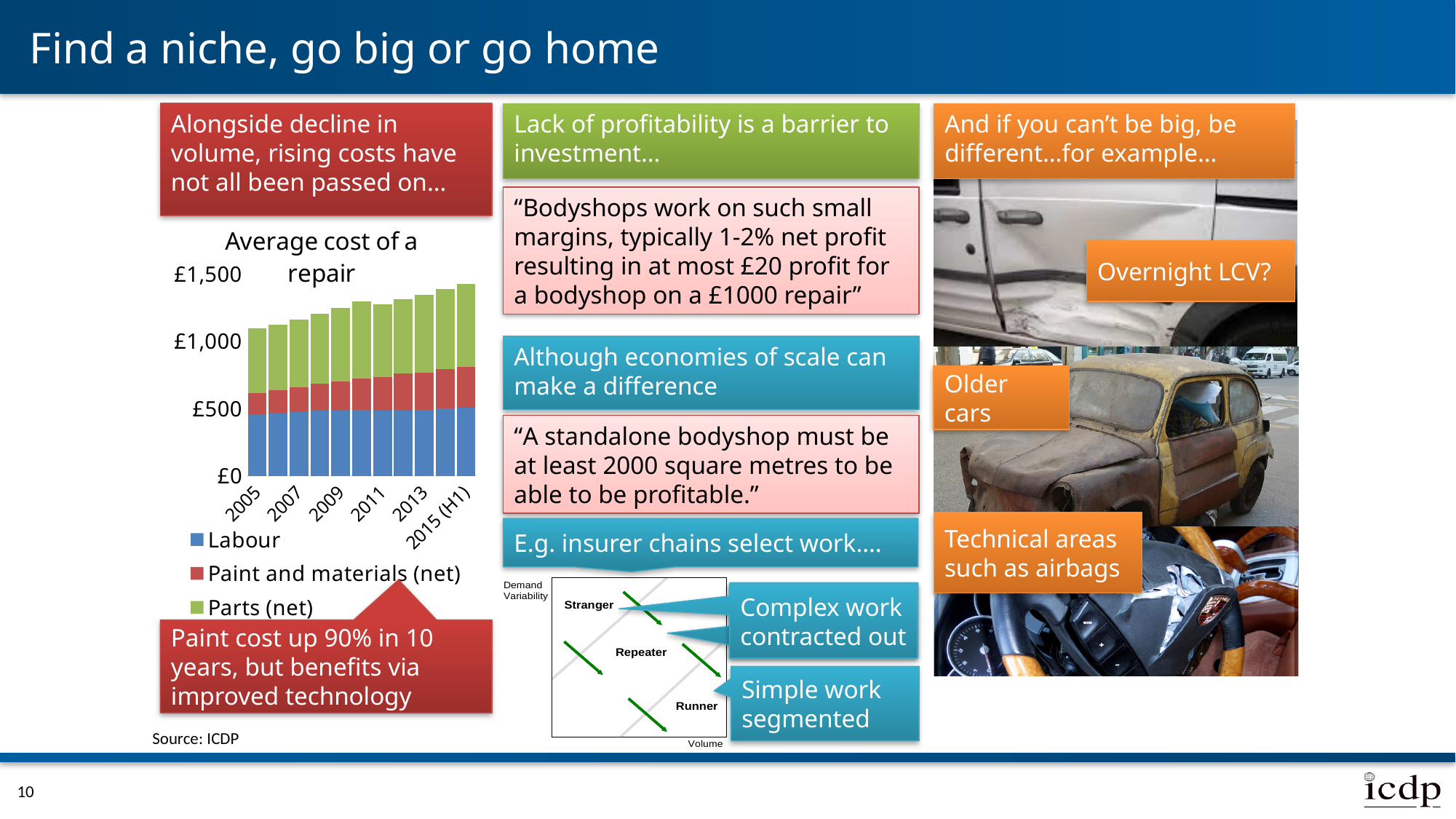
Do the total bar heights in the 'Average cost of a repair' chart rise or fall from 2005 to 2015 (H1)? rise In the 'Average cost of a repair' chart, is the total bar for 2015 (H1) greater or less than £1,000? greater How many bars are plotted in the 'Average cost of a repair' chart? 11 In the 'Average cost of a repair' chart, is the total bar for 2005 greater or less than £1,000? greater How many series does the legend of the 'Average cost of a repair' chart list? 3 In the 'Average cost of a repair' chart, which year has the lowest total bar? 2005 Which series is shown at the bottom of each stacked bar in the 'Average cost of a repair' chart? Labour What kind of chart is the 'Average cost of a repair' chart? bar chart What are the three series listed in the legend of the 'Average cost of a repair' chart? Labour, Paint and materials (net), Parts (net) In the 'Average cost of a repair' chart, which segment is larger in the 2015 (H1) bar: Parts (net) or Paint and materials (net)? Parts (net) In the 'Average cost of a repair' chart, is the total bar for 2015 (H1) greater or less than £1,500? less In the 'Average cost of a repair' chart, which year has the highest total bar? 2015 (H1)